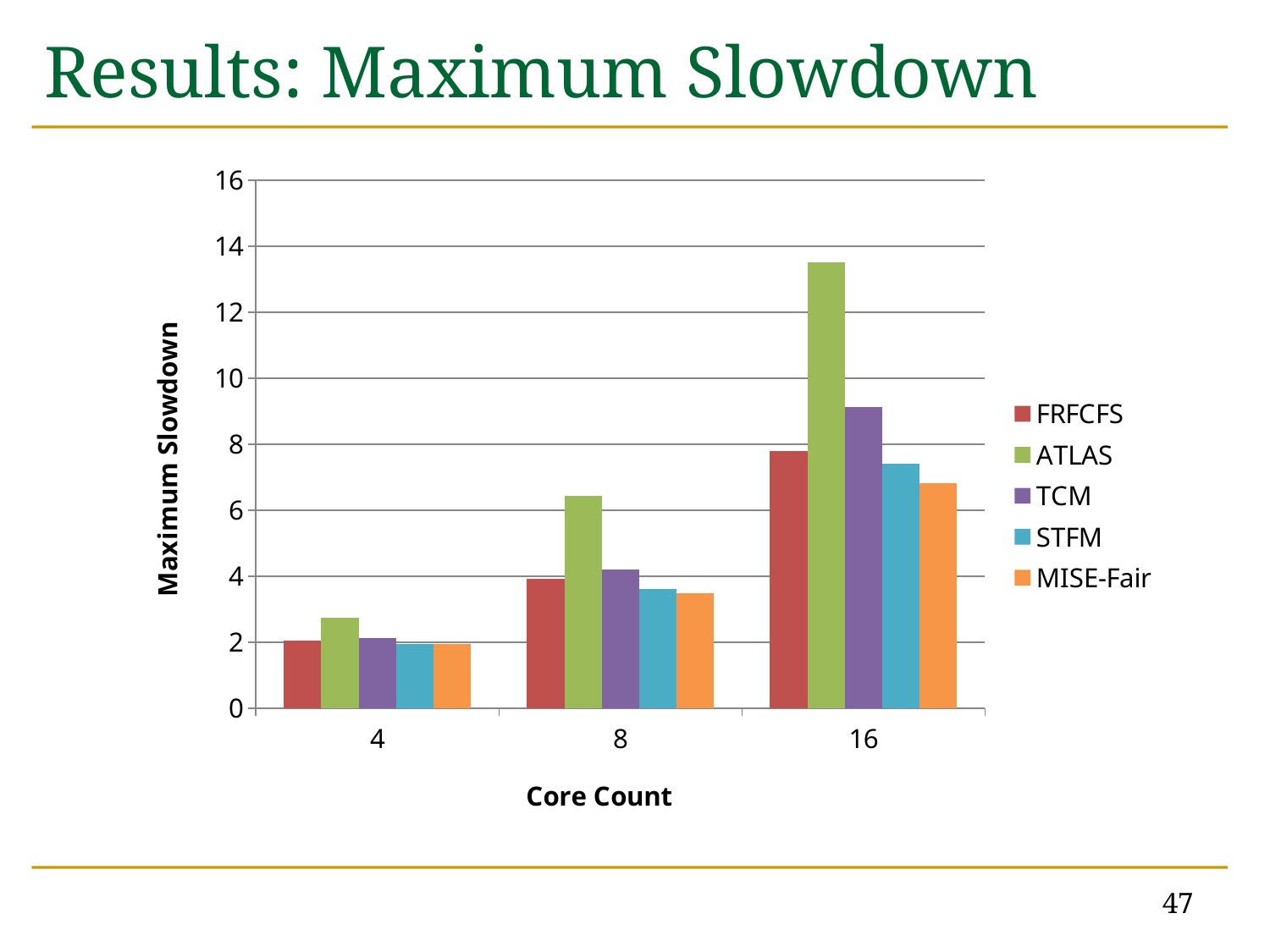
Does the maximum slowdown for ATLAS rise or fall as the core count increases from 4 to 16? rise At a core count of 8, which has the larger maximum slowdown, ATLAS or TCM? ATLAS Is the maximum slowdown for MISE-Fair at a core count of 8 greater or less than 4? less How many core count categories are shown on the x axis? 3 Is the maximum slowdown for TCM at a core count of 16 greater or less than 8? greater How many series does the legend list? 5 Which scheduler has the lowest maximum slowdown at a core count of 16? MISE-Fair Is the maximum slowdown for ATLAS at a core count of 16 greater or less than 12? greater What is the title of the y axis? Maximum Slowdown Which scheduler has the highest maximum slowdown at a core count of 16? ATLAS What kind of chart is shown on the slide? bar chart Which scheduler has the highest maximum slowdown at a core count of 8? ATLAS